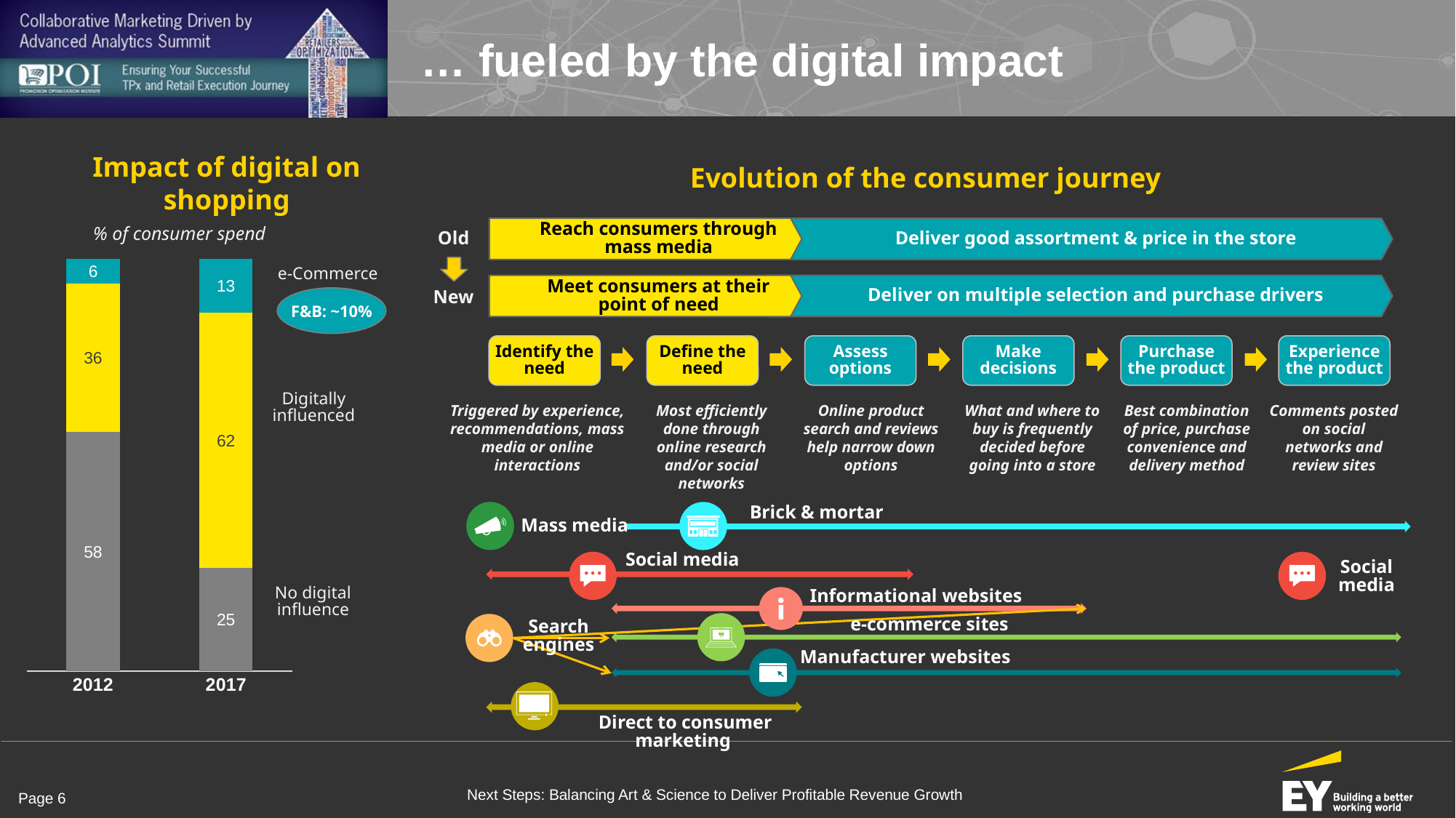
In the 'Impact of digital on shopping' chart, what is the 'No digital influence' value for 2012? 58 In the 'Impact of digital on shopping' chart, does the e-Commerce value rise or fall from 2012 to 2017? Rise In the 'Impact of digital on shopping' chart, which year has the higher 'No digital influence' value, 2012 or 2017? 2012 How many years (categories) are shown on the x axis of the 'Impact of digital on shopping' chart? 2 In the 'Impact of digital on shopping' chart, what is the e-Commerce value for 2012? 6 In the 'Impact of digital on shopping' chart, what is the total of the stacked bar for 2017? 100 In the 'Impact of digital on shopping' chart, by how much did the 'Digitally influenced' value increase from 2012 to 2017? 26 In the 'Impact of digital on shopping' chart, what is the e-Commerce value for 2017? 13 In the 'Impact of digital on shopping' chart, what is the 'Digitally influenced' value for 2017? 62 How many series are shown in the 'Impact of digital on shopping' chart? 3 In the 'Impact of digital on shopping' chart, what is the difference between the 'No digital influence' values for 2012 and 2017? 33 What kind of chart is 'Impact of digital on shopping'? Stacked bar chart